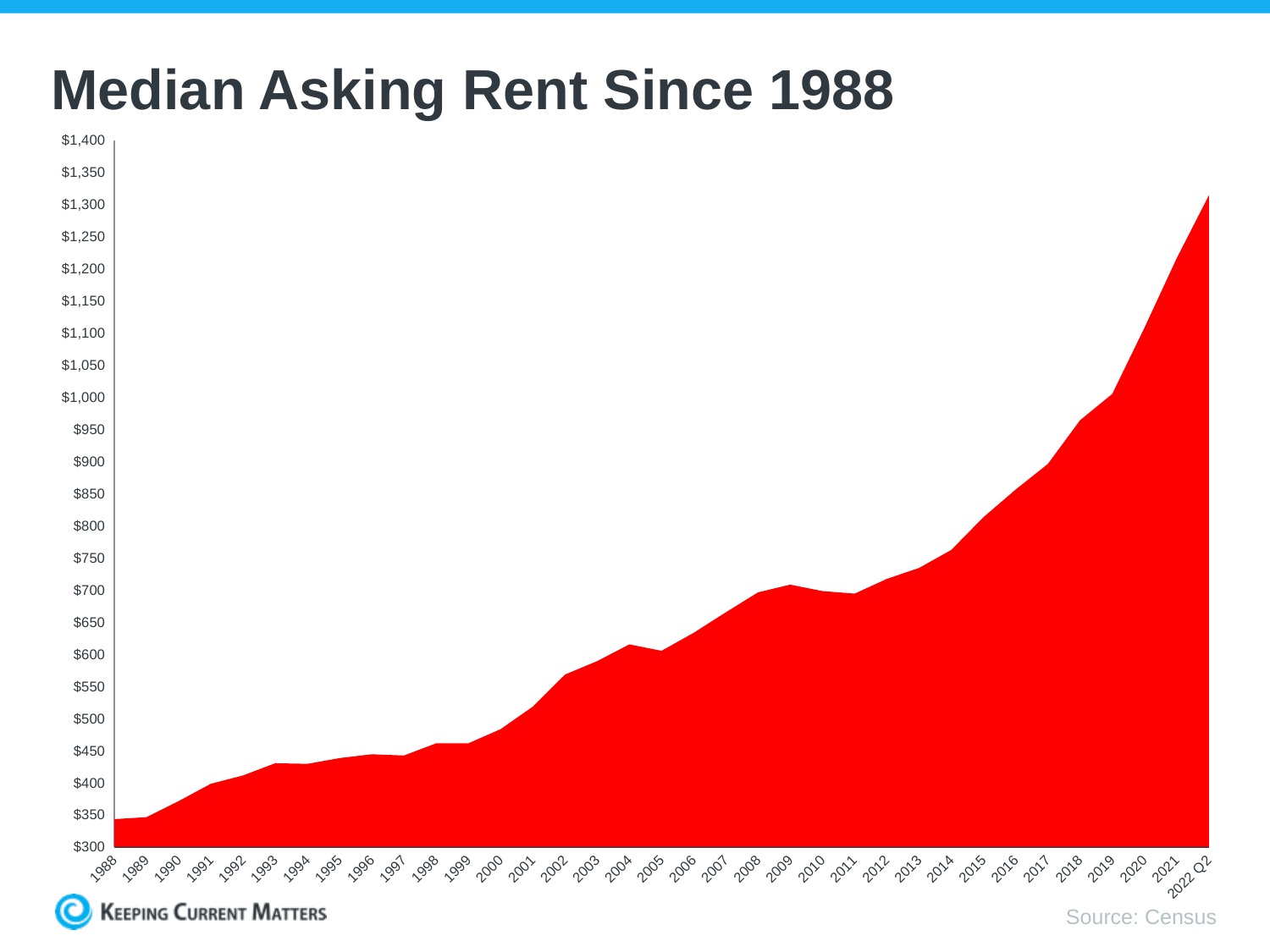
Which year has the highest median asking rent? 2022 Q2 What colour is the area fill in the chart? red Is the value for 2018 greater or less than $900? greater Which year has the lowest median asking rent? 1988 Is the value for 2022 Q2 greater or less than $1,250? greater How many points are plotted along the x axis? 35 Which is larger, the value for 2009 or the value for 2013? 2013 What is the title of the chart? Median Asking Rent Since 1988 Overall, do median asking rents rise or fall from 1988 to 2022 Q2? rise Is the value for 2000 greater or less than $500? less What kind of chart is shown on the slide? area chart